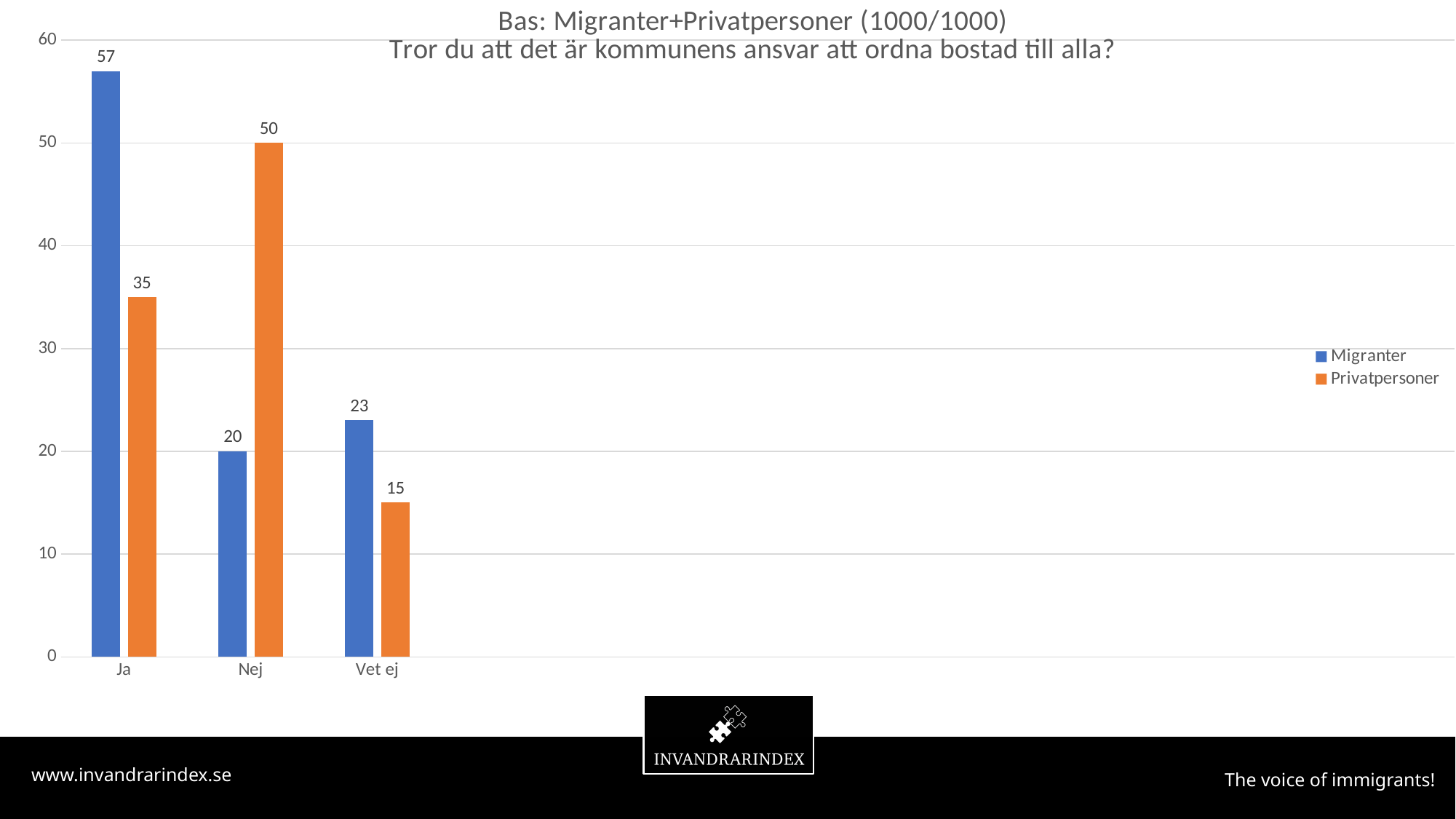
What is the value for Migranter in the Ja category? 57 What is the value for Migranter in the Nej category? 20 What kind of chart is shown on the slide? Bar chart What is the value for Privatpersoner in the Nej category? 50 Which is larger in the Nej category, Migranter or Privatpersoner? Privatpersoner Which category has the highest value for Migranter? Ja How many series does the legend list? 2 Which category has the lowest value for Privatpersoner? Vet ej Which colour represents the Privatpersoner series? Orange What is the value for Privatpersoner in the Vet ej category? 15 What is the difference between the Migranter and Privatpersoner values in the Ja category? 22 How many categories are shown on the x axis? 3